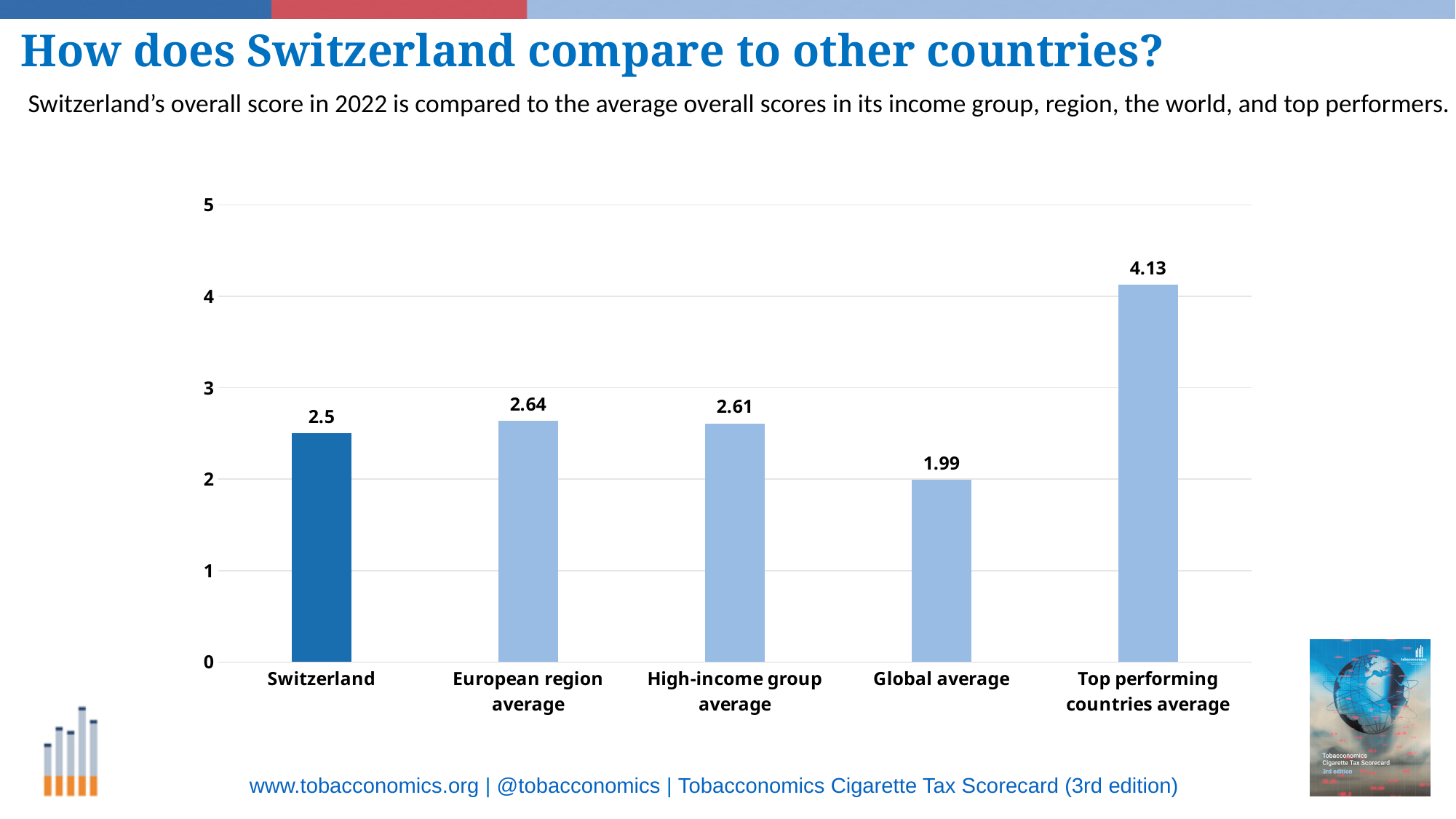
How many categories are shown on the chart? 5 What is the difference between the High-income group average and the Global average? 0.62 What is the value for the Global average? 1.99 Which category has the highest value? Top performing countries average What kind of chart is shown on the slide? Bar chart What is the difference between the Top performing countries average and Switzerland? 1.63 Which is larger, the value for Switzerland or the Global average? Switzerland Is the value for the Top performing countries average greater or less than 4? greater What is the value for Switzerland? 2.5 What is the value for the Top performing countries average? 4.13 Which category has the lowest value? Global average What is the value for the European region average? 2.64